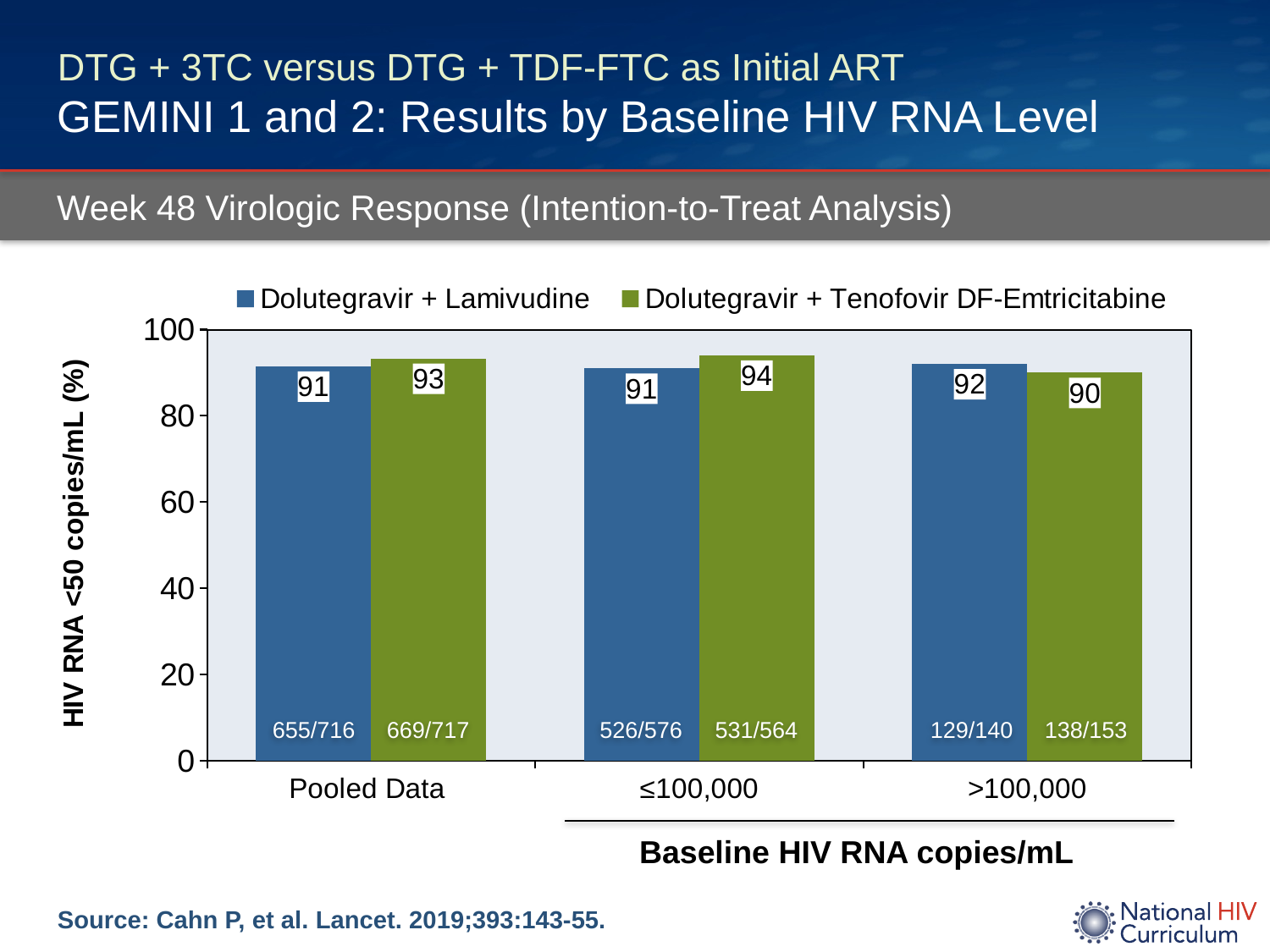
What is the label of the y axis? HIV RNA <50 copies/mL (%) How many series does the legend list? 2 What is the value for Dolutegravir + Tenofovir DF-Emtricitabine in the ≤100,000 category? 94 What is the value for Dolutegravir + Tenofovir DF-Emtricitabine in the >100,000 category? 90 What kind of chart is shown on the slide? Bar chart How many categories are shown on the x axis? 3 What is the value for Dolutegravir + Lamivudine in the >100,000 category? 92 What is the difference between the two series' values in the ≤100,000 category? 3 What fraction is printed at the base of the Dolutegravir + Lamivudine bar for Pooled Data? 655/716 What fraction is printed at the base of the Dolutegravir + Tenofovir DF-Emtricitabine bar for >100,000? 138/153 What is the value for Dolutegravir + Lamivudine in the Pooled Data category? 91 In the >100,000 category, which series has the higher value? Dolutegravir + Lamivudine